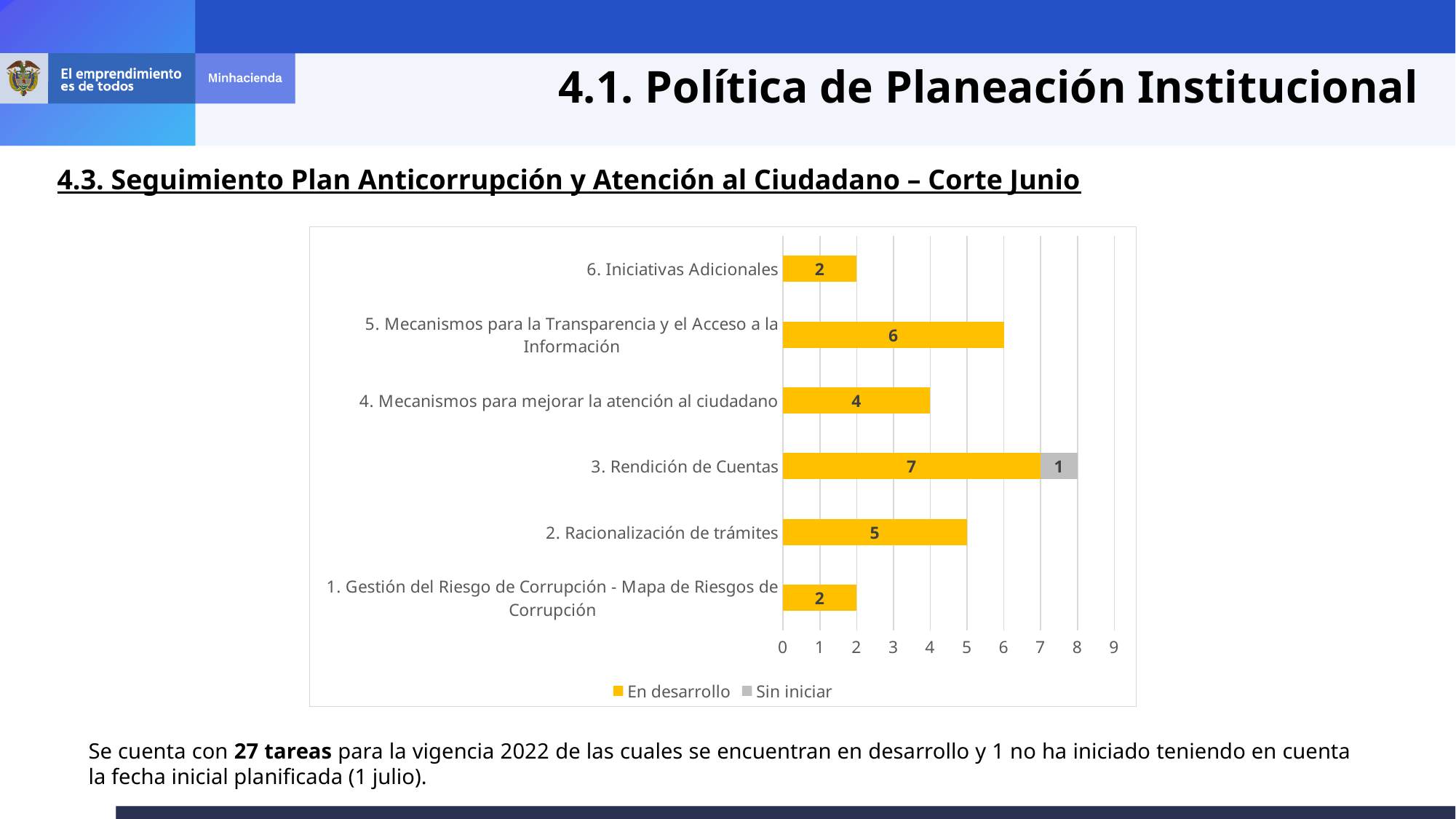
What is the total of the stacked bar for '3. Rendición de Cuentas'? 8 What is the 'En desarrollo' value for '2. Racionalización de trámites'? 5 What kind of chart is shown on the slide? Bar chart Which colour represents the 'Sin iniciar' series? Grey How many categories are shown on the chart? 6 What is the difference between the 'En desarrollo' values for '5. Mecanismos para la Transparencia y el Acceso a la Información' and '4. Mecanismos para mejorar la atención al ciudadano'? 2 Which category has the highest 'En desarrollo' value? 3. Rendición de Cuentas Which has a larger 'En desarrollo' value: '2. Racionalización de trámites' or '6. Iniciativas Adicionales'? 2. Racionalización de trámites What is the 'En desarrollo' value for '5. Mecanismos para la Transparencia y el Acceso a la Información'? 6 What is the 'Sin iniciar' value for '3. Rendición de Cuentas'? 1 How many series does the legend list? 2 What is the 'En desarrollo' value for '3. Rendición de Cuentas'? 7